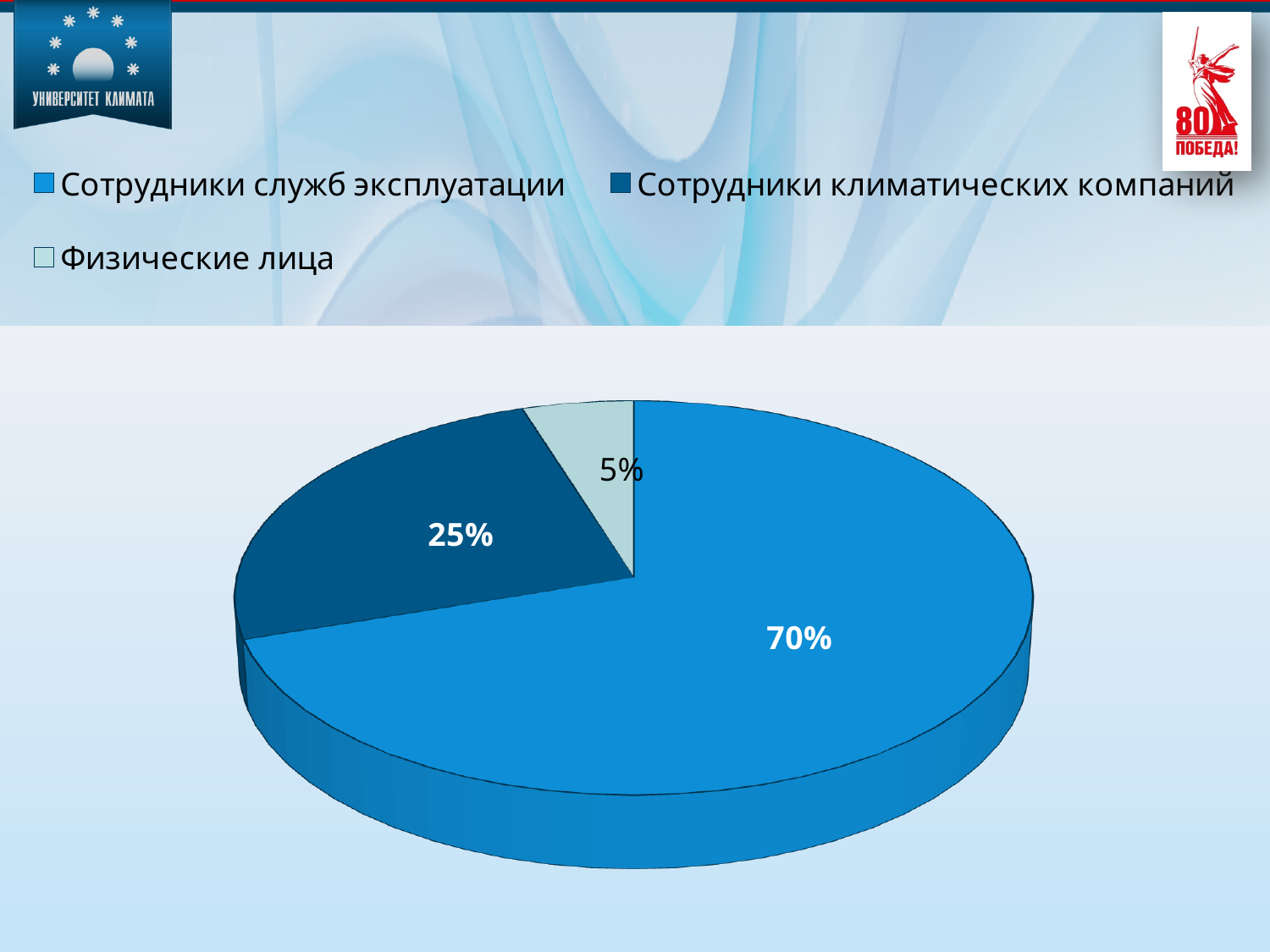
What kind of chart is shown on the slide? pie chart Which category has the largest slice of the pie? Сотрудники служб эксплуатации How many slices does the pie chart have? 3 How many entries does the legend list? 3 What share of the pie does Сотрудники служб эксплуатации have? 70% Which category has the smallest slice of the pie? Физические лица What is the difference between the shares of Сотрудники климатических компаний and Физические лица? 20% Which is larger: the share of Сотрудники климатических компаний or the share of Физические лица? Сотрудники климатических компаний What share of the pie does Сотрудники климатических компаний have? 25% What is the difference between the shares of Сотрудники служб эксплуатации and Сотрудники климатических компаний? 45% Which legend entry is shown in the lightest colour? Физические лица What share of the pie does Физические лица have? 5%